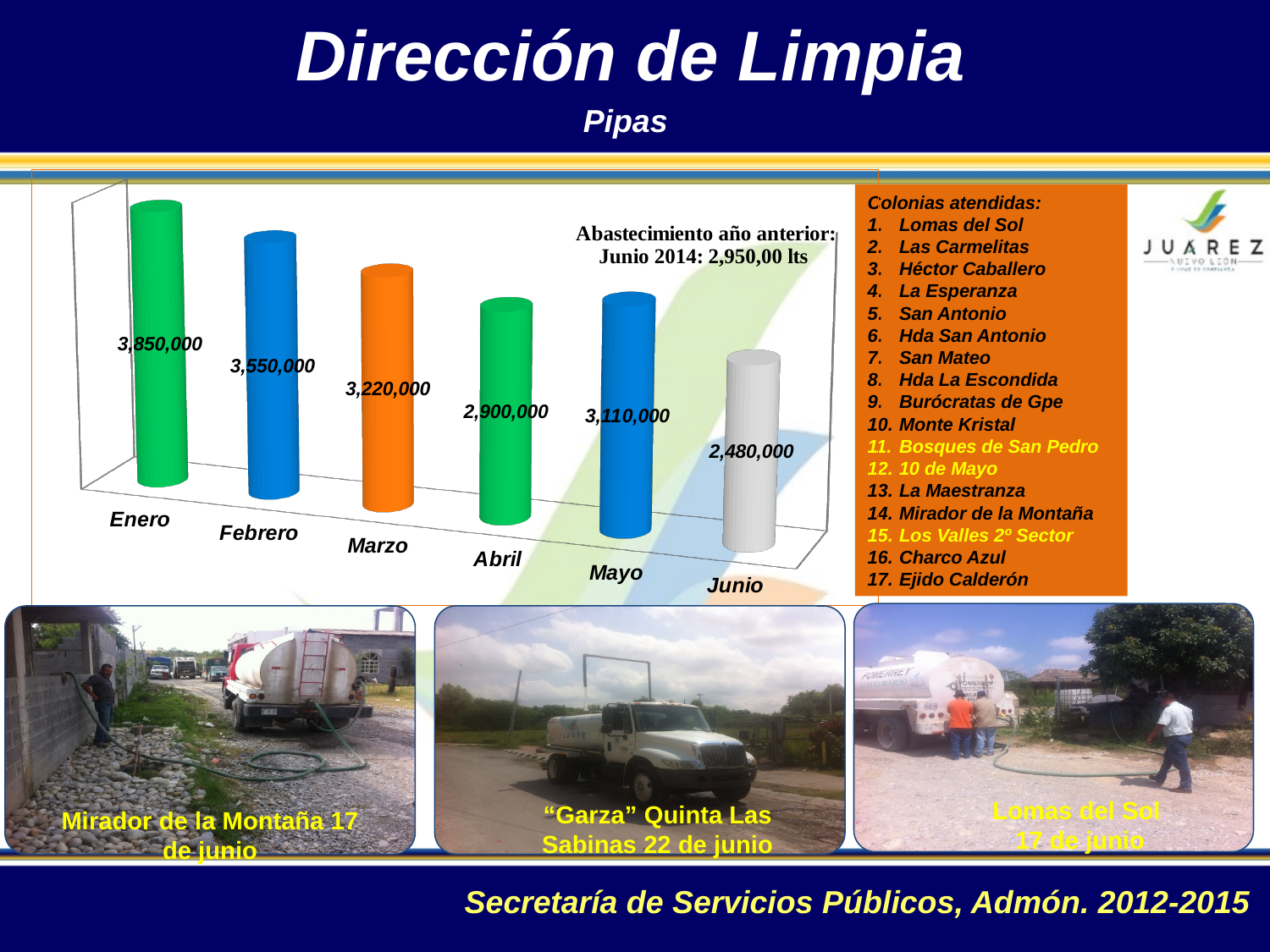
What kind of chart is shown on the slide? Bar chart Which month has the highest value? Enero What is the value for Junio? 2,480,000 What is the value for Abril? 2,900,000 What is the value for Enero? 3,850,000 What is the difference between the values for Enero and Febrero? 300,000 What is the difference between the values for Mayo and Junio? 630,000 How many months are shown in the chart? 6 Which month has the lowest value? Junio Do the values rise or fall from Enero to Abril? Fall What is the value for Mayo? 3,110,000 Which is larger, the value for Abril or the value for Mayo? Mayo